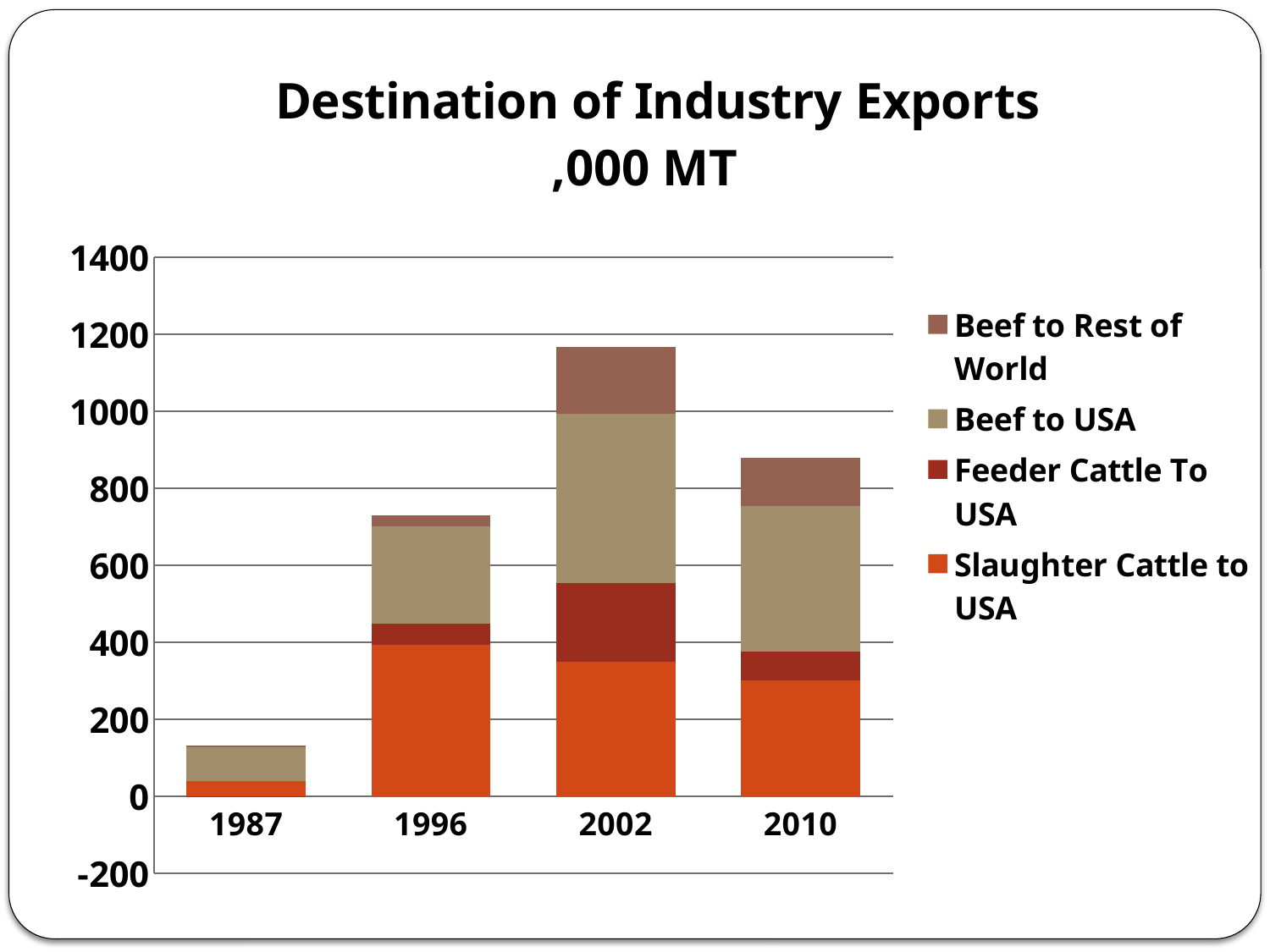
How many years are shown on the x axis of the chart? 4 Which year has the larger total exports, 1996 or 2010? 2010 Is the total for 2002 greater or less than 1000? greater How many series does the legend list? 4 Is the total for 2010 greater or less than 1000? less Is the Slaughter Cattle to USA value for 2010 greater or less than 400? less Which year has the highest total exports? 2002 Do total exports rise or fall from 2002 to 2010? fall What kind of chart is shown on the slide? Stacked bar chart Which year has the lowest total exports? 1987 What is the title of the chart? Destination of Industry Exports ,000 MT